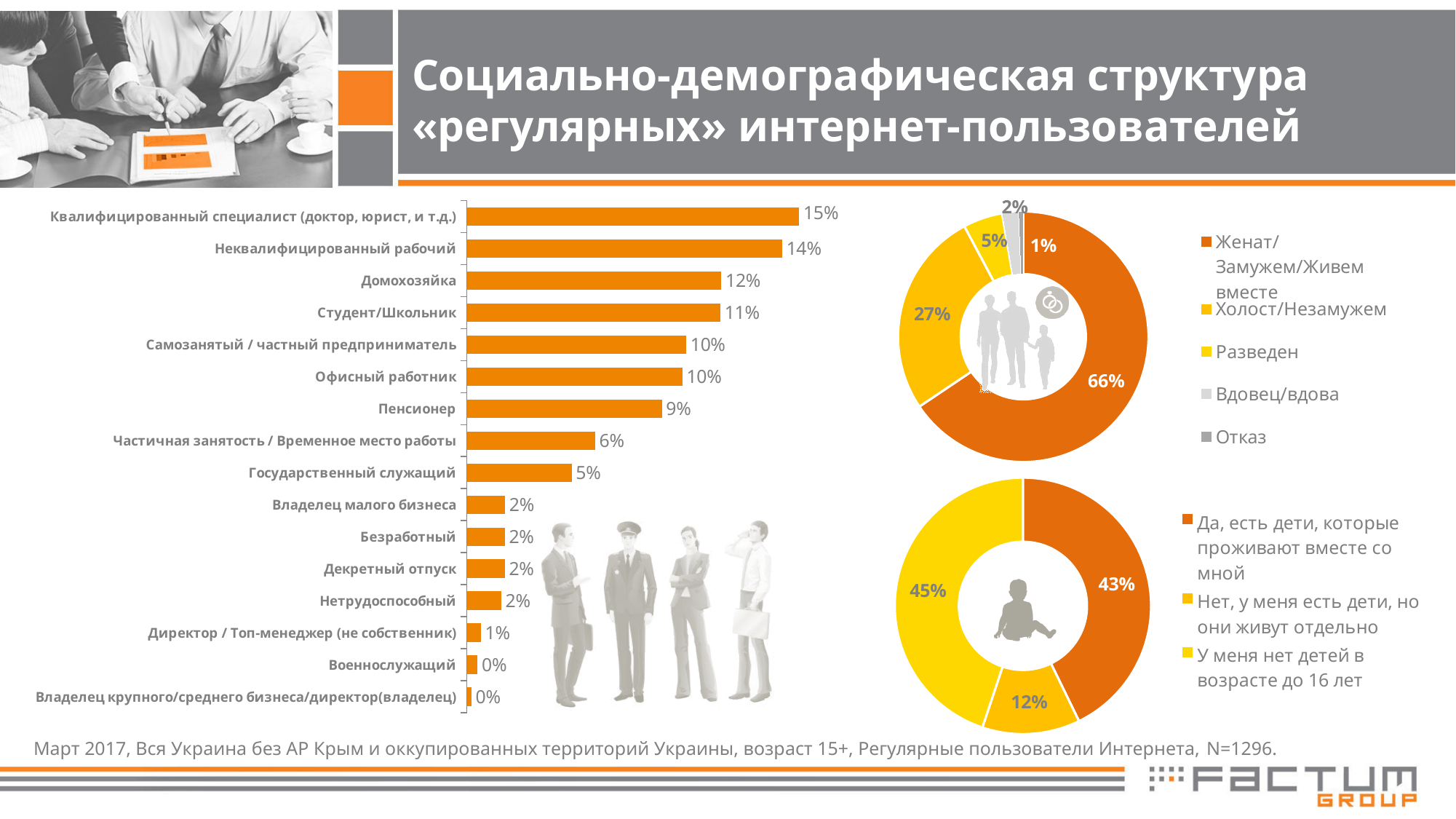
In the bar chart on the left, which is larger: Студент/Школьник or Государственный служащий? Студент/Школьник In the bar chart on the left, which category has the highest value? Квалифицированный специалист (доктор, юрист, и т.д.) In the lower donut chart on the right, what is the difference between 'У меня нет детей в возрасте до 16 лет' and 'Да, есть дети, которые проживают вместе со мной'? 2% In the bar chart on the left, what is the value for Домохозяйка? 12% In the bar chart on the left, what is the difference between Неквалифицированный рабочий and Пенсионер? 5% How many categories does the bar chart on the left show? 16 In the lower donut chart on the right, what share is 'Нет, у меня есть дети, но они живут отдельно'? 12% What kind of chart is the chart on the left of the slide? Bar chart How many entries does the legend of the upper donut chart on the right list? 5 In the lower donut chart on the right, which category has the smallest share? Нет, у меня есть дети, но они живут отдельно In the upper donut chart on the right, which category has the largest share? Женат/Замужем/Живем вместе In the upper donut chart on the right, what share is Холост/Незамужем? 27%